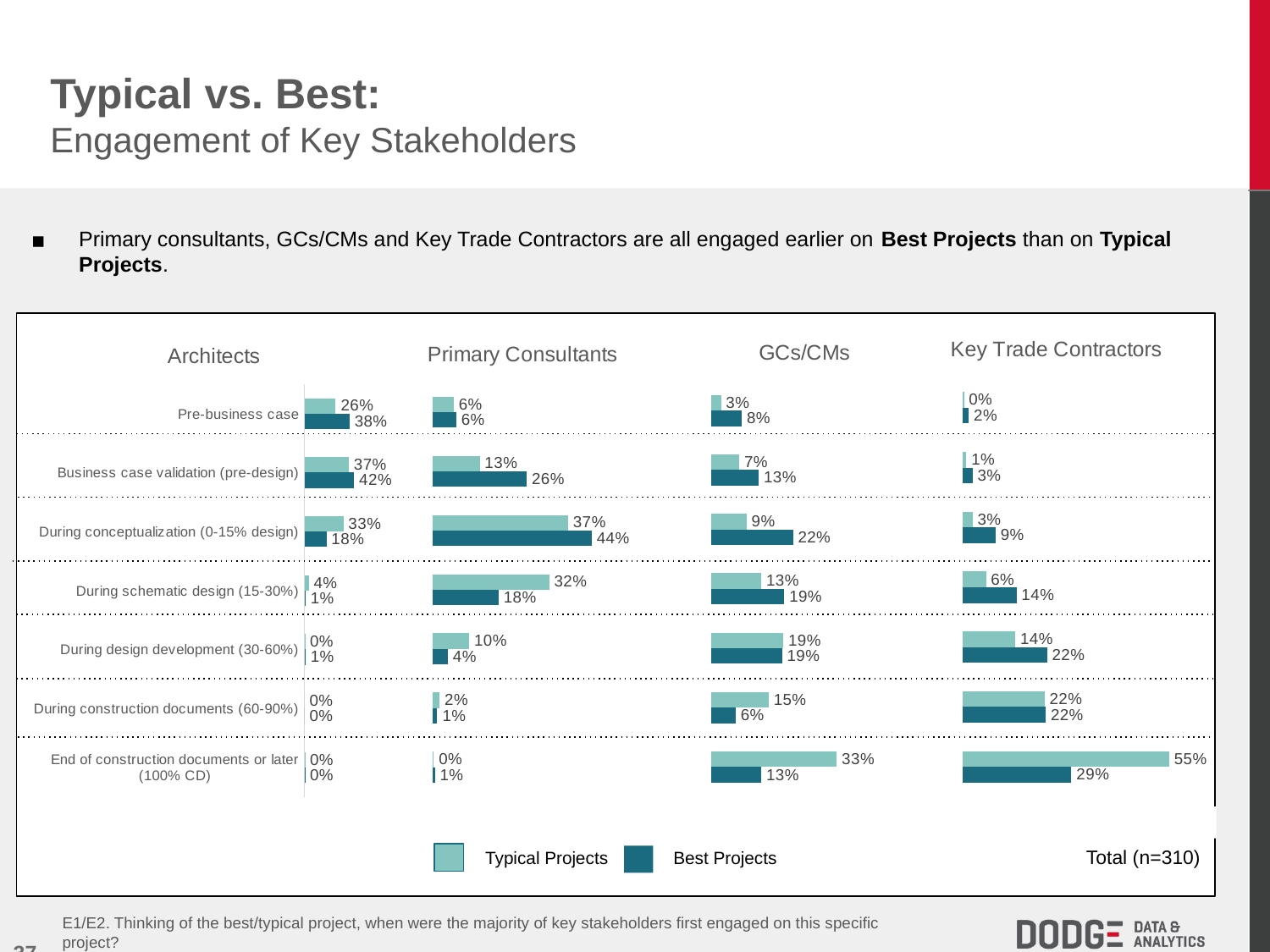
What kind of chart is used for the Architects panel? Bar chart In the Primary Consultants chart, which is larger for During schematic design (15-30%): the Typical Projects value or the Best Projects value? Typical Projects In the Architects chart, which stage has the highest Best Projects value? Business case validation (pre-design) How many stages (categories) are shown in each chart? 7 In the Key Trade Contractors chart, what is the difference between the Best Projects and Typical Projects values for During schematic design (15-30%)? 8% In the GCs/CMs chart, what is the difference between the Typical Projects and Best Projects values for End of construction documents or later (100% CD)? 20% In the Architects chart, what is the Typical Projects value for Pre-business case? 26% In the Primary Consultants chart, what is the Best Projects value for During conceptualization (0-15% design)? 44% How many series does the legend list? 2 In the GCs/CMs chart, which stage has the highest Typical Projects value? End of construction documents or later (100% CD) What sample size is shown in the bottom right of the chart area? Total (n=310) In the Key Trade Contractors chart, what is the Typical Projects value for End of construction documents or later (100% CD)? 55%